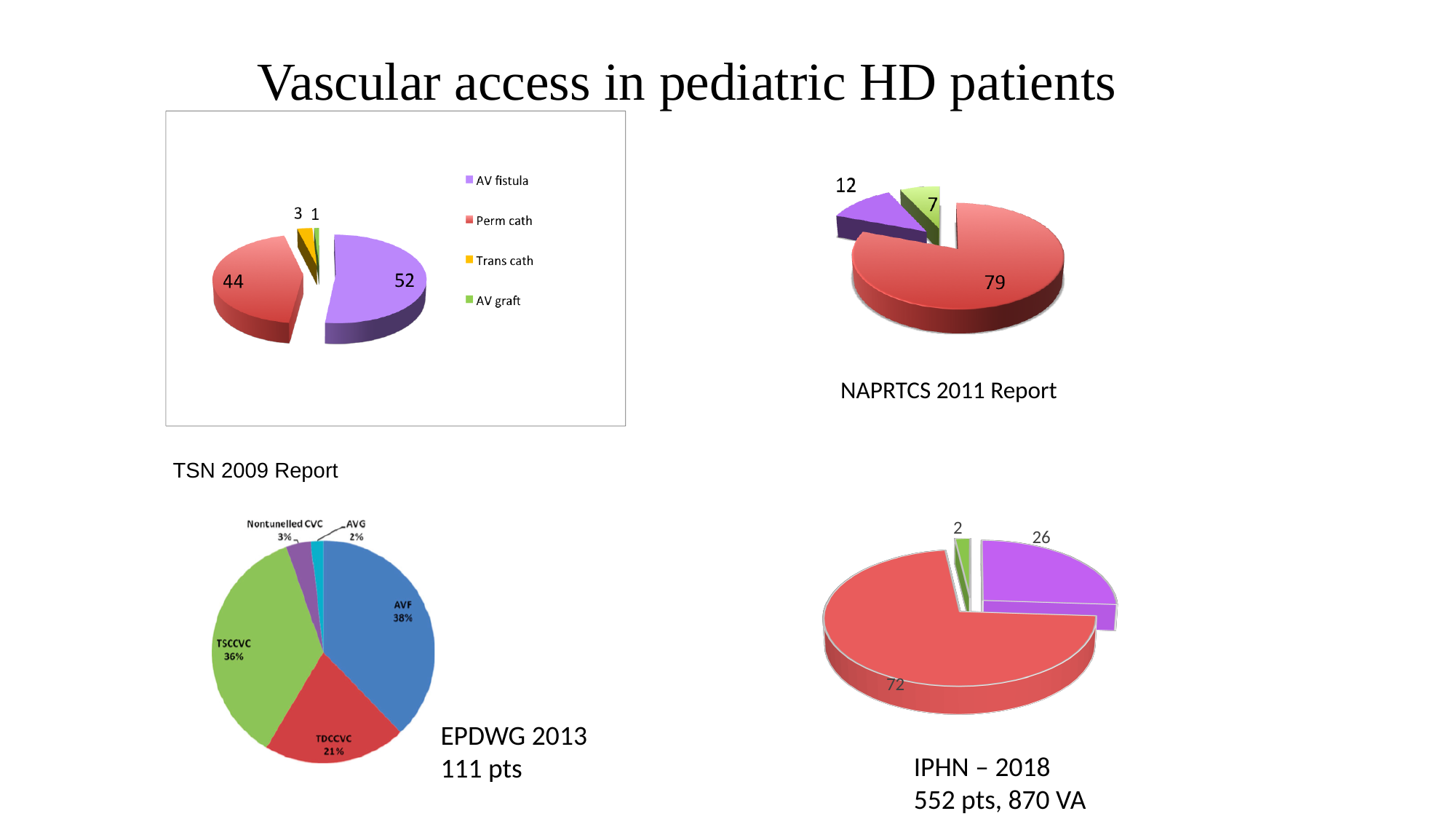
How many slices does the NAPRTCS 2011 Report chart have? 3 In the TSN 2009 Report chart, which category has the smallest slice? AV graft In the EPDWG 2013 chart, what share does AVF have? 38% In the EPDWG 2013 chart, which category has the smallest share? AVG In the TSN 2009 Report chart, what is the difference between the AV fistula and Perm cath values? 8 In the EPDWG 2013 chart, what share does TDCCVC have? 21% In the TSN 2009 Report chart, which category has the largest slice? AV fistula In the NAPRTCS 2011 Report chart, what is the value of the largest slice? 79 In the TSN 2009 Report chart, what is the value for AV fistula? 52 In the TSN 2009 Report chart, what is the value for Perm cath? 44 In the IPHN – 2018 chart, what is the value of the largest slice? 72 How many entries does the legend of the TSN 2009 Report chart list? 4